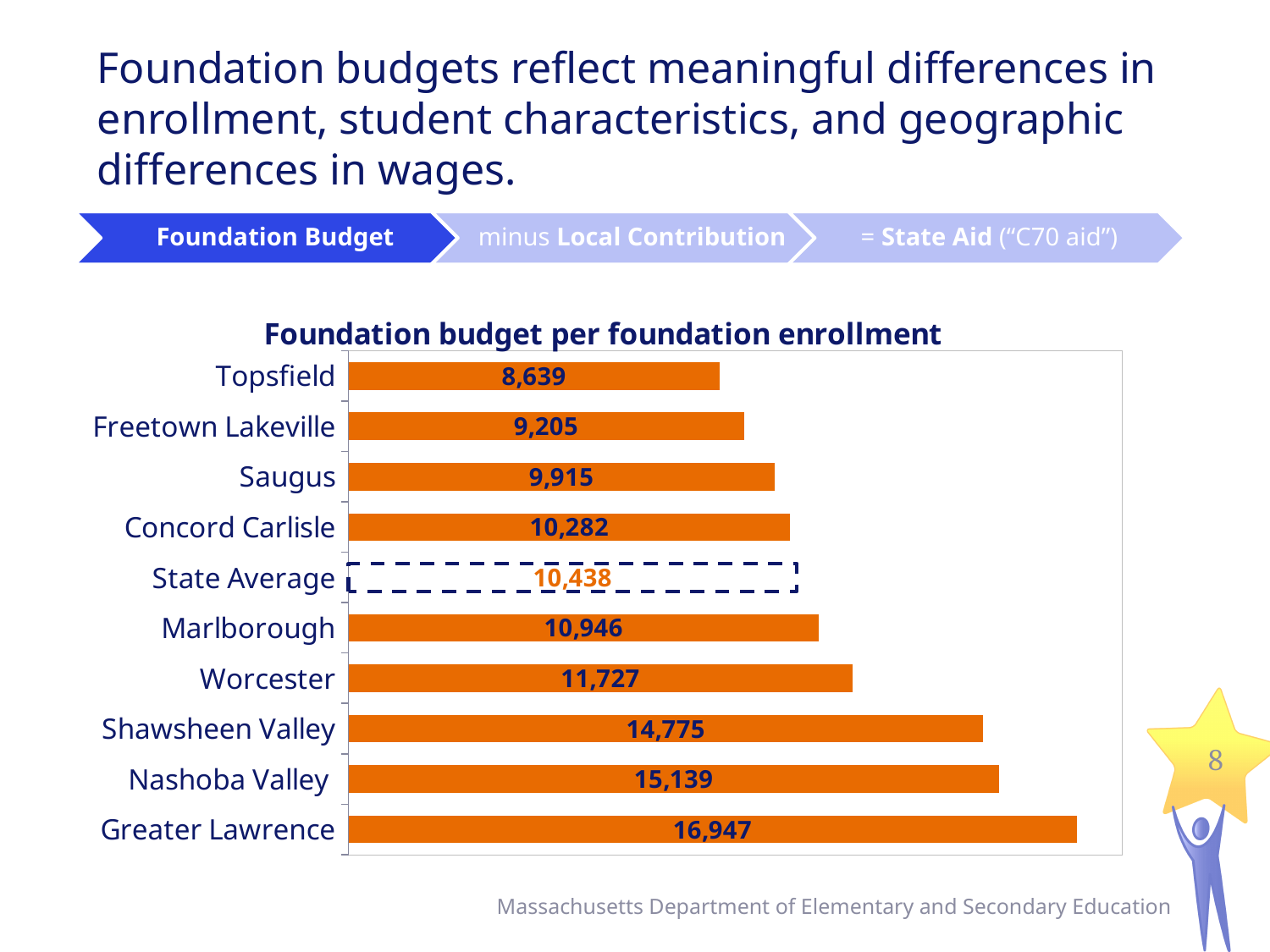
What is the foundation budget per foundation enrollment for Saugus? 9,915 Which district has the lowest foundation budget per foundation enrollment? Topsfield What is the title of the chart? Foundation budget per foundation enrollment What is the value shown for the State Average? 10,438 How many bars are shown in the chart, including the State Average? 10 What kind of chart is shown on the slide? Bar chart Which district has the highest foundation budget per foundation enrollment? Greater Lawrence What is the foundation budget per foundation enrollment for Worcester? 11,727 What is the difference between the values for Nashoba Valley and Shawsheen Valley? 364 Which has a larger value, Marlborough or Concord Carlisle? Marlborough Which has a larger value, Freetown Lakeville or Worcester? Worcester What is the difference between the values for Greater Lawrence and Topsfield? 8,308